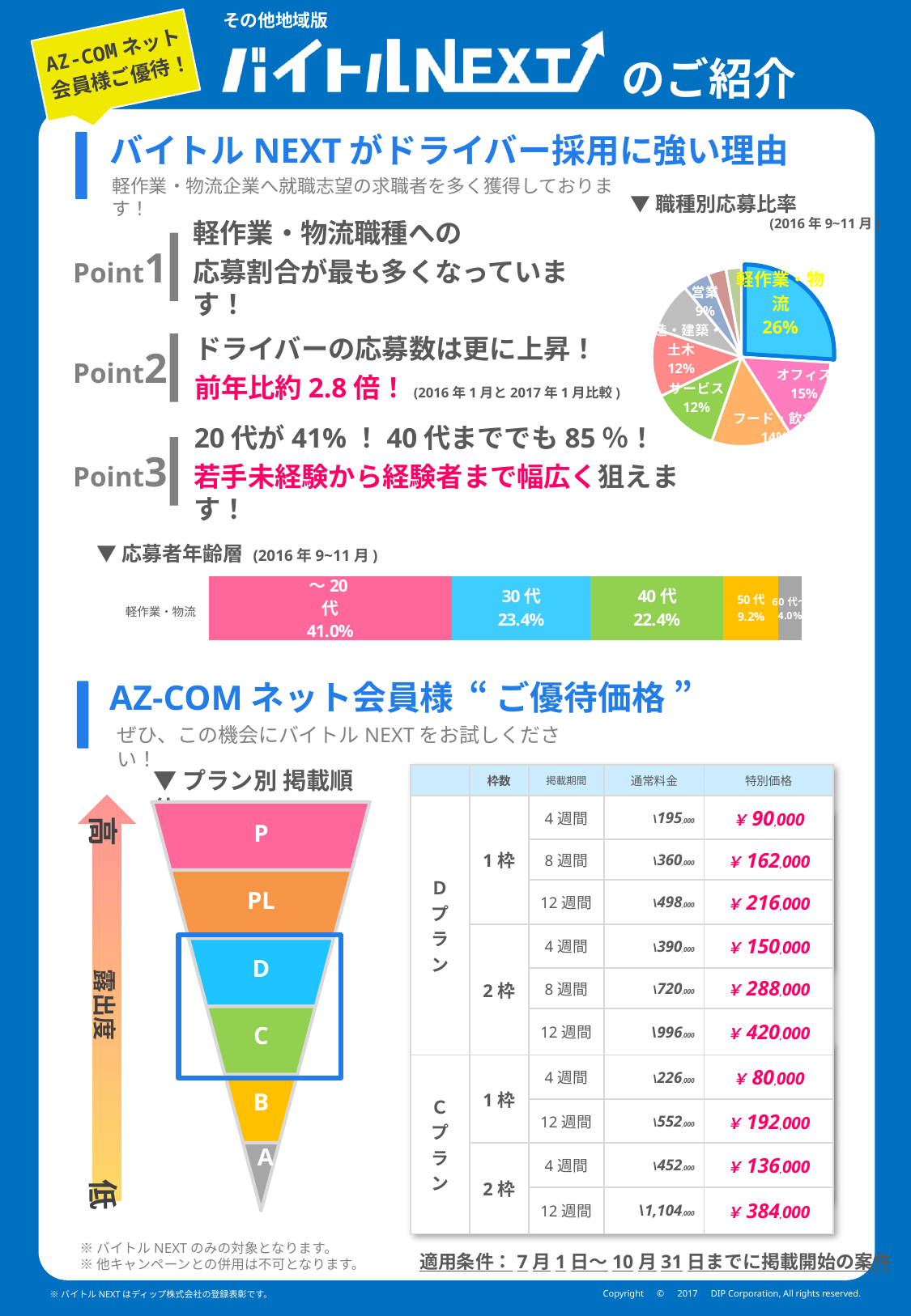
In the 応募者年齢層 bar chart, what is the difference between the 30代 and 40代 shares? 1.0 percentage point In the 職種別応募比率 pie chart, what share is shown for オフィス? 15% In the 職種別応募比率 pie chart, which category has the largest share? 軽作業・物流 In the 職種別応募比率 pie chart, how many percentage points larger is 軽作業・物流 than オフィス? 11 percentage points In the 応募者年齢層 bar chart, what percentage is shown for 30代? 23.4% How many age-group segments are shown in the 応募者年齢層 bar chart? 5 What kind of chart is the 職種別応募比率 chart? Pie chart In the 応募者年齢層 bar chart, which age group has the largest share? ～20代 In the 職種別応募比率 pie chart, which has the larger share, サービス or 営業? サービス In the 職種別応募比率 pie chart, what share is shown for 営業? 9% In the 応募者年齢層 bar chart, which age group has the smallest share? 60代～ In the 職種別応募比率 pie chart, what share is shown for 軽作業・物流? 26%